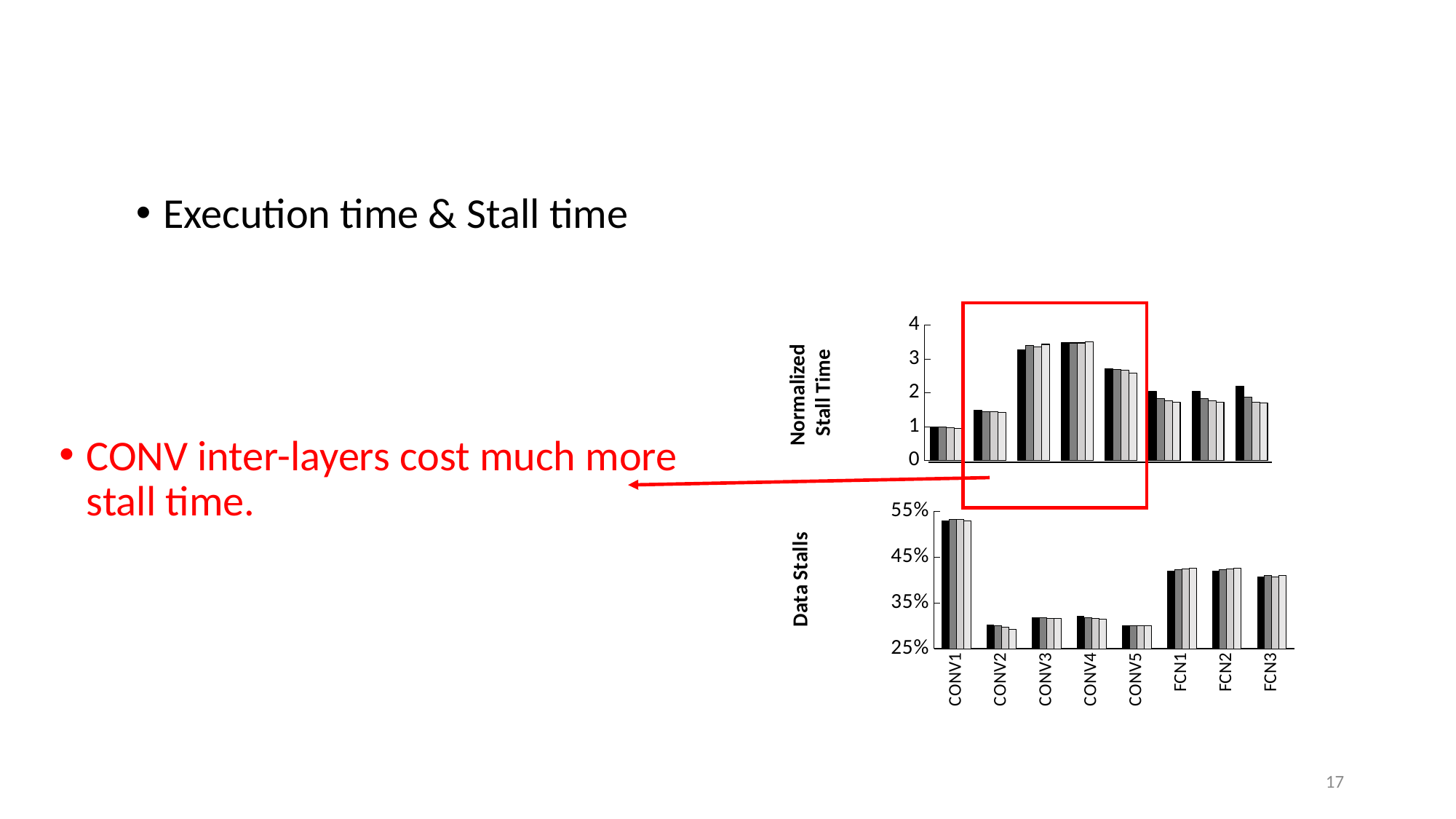
In the top chart (Normalized Stall Time), is the value for CONV4 greater or less than 3? greater In the bottom chart (Data Stalls), is the value for CONV3 greater or less than 35%? less What is the y-axis label of the top chart? Normalized Stall Time In the bottom chart (Data Stalls), is the value for FCN1 greater or less than 45%? less In the top chart (Normalized Stall Time), which is larger, the value for CONV3 or the value for CONV2? CONV3 How many categories are shown on the x axis of the bottom chart labelled Data Stalls? 8 In the bottom chart (Data Stalls), which is larger, the value for CONV1 or the value for FCN1? CONV1 What type of chart is the top chart labelled Normalized Stall Time? bar chart In the top chart (Normalized Stall Time), which category has the lowest values? CONV1 In the bottom chart (Data Stalls), which category has the highest value? CONV1